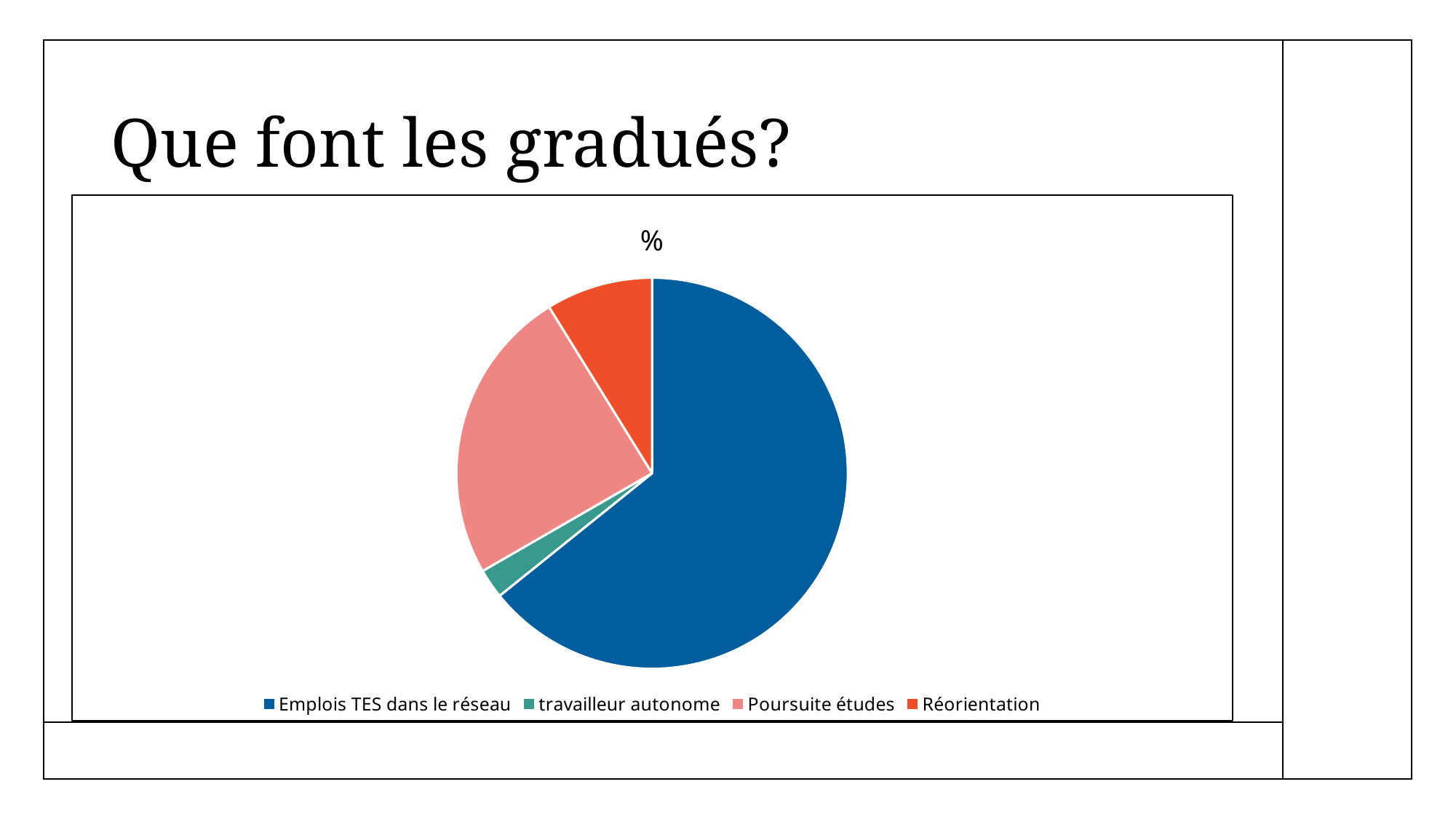
Which slice is larger, Poursuite études or Réorientation? Poursuite études Which category has the largest slice of the pie chart? Emplois TES dans le réseau Which category has the second-largest slice of the pie chart? Poursuite études Which slice is larger, Réorientation or travailleur autonome? Réorientation Which slice is larger, Emplois TES dans le réseau or Poursuite études? Emplois TES dans le réseau What colour is the Emplois TES dans le réseau slice? blue How many categories does the pie chart show? 4 Does the Emplois TES dans le réseau slice take up more or less than half of the pie? more What is the title shown above the pie chart? % Which category has the smallest slice of the pie chart? travailleur autonome What kind of chart is shown on the slide? pie chart